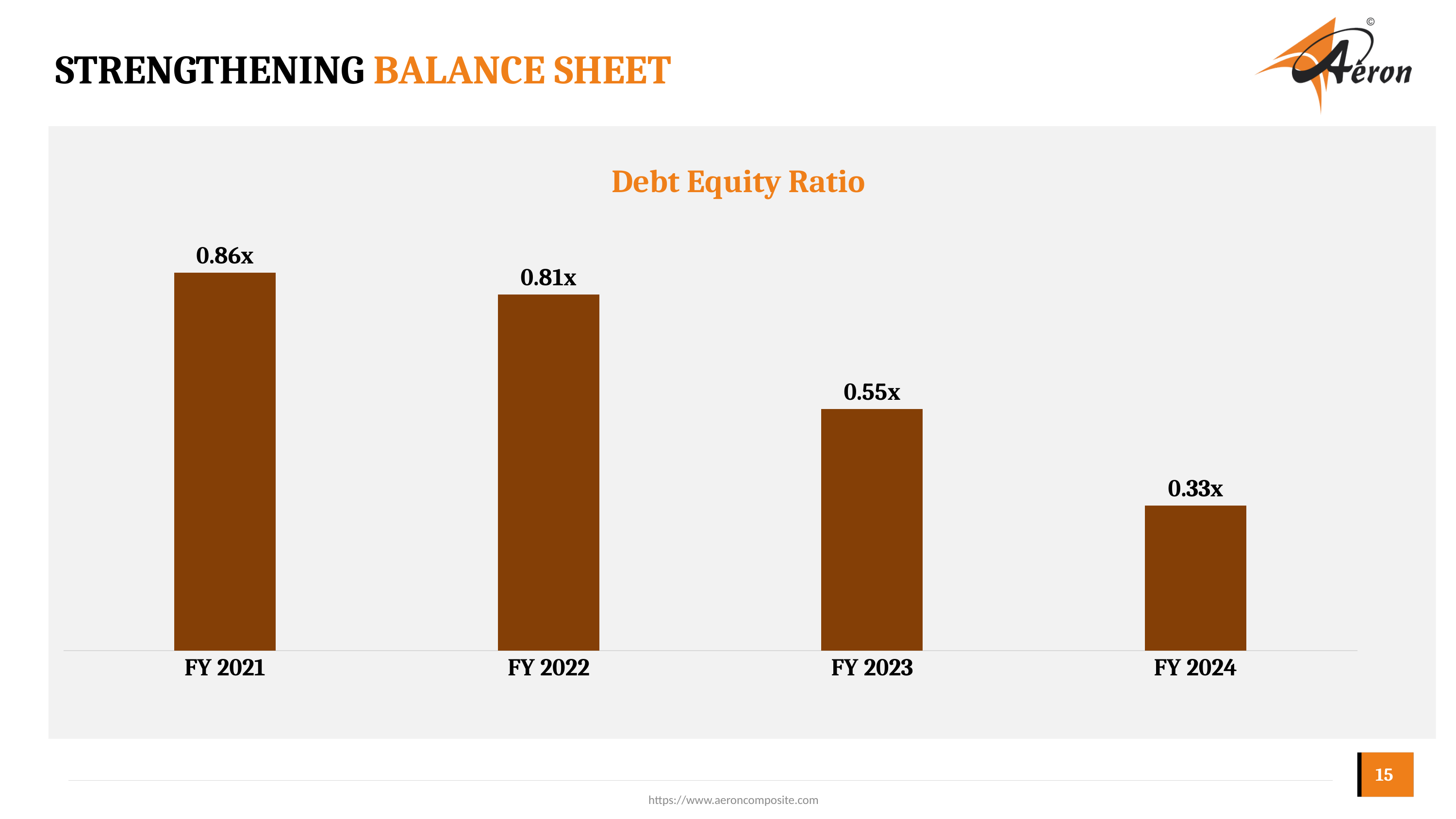
What is the difference between the Debt Equity Ratio in FY 2021 and FY 2024? 0.53x What kind of chart is used to show the Debt Equity Ratio? Bar chart Which fiscal year has the highest Debt Equity Ratio? FY 2021 Which is larger, the Debt Equity Ratio in FY 2022 or in FY 2023? FY 2022 What is the Debt Equity Ratio for FY 2022? 0.81x What is the Debt Equity Ratio for FY 2024? 0.33x Which fiscal year has the lowest Debt Equity Ratio? FY 2024 How many fiscal years are shown in the Debt Equity Ratio chart? 4 What is the Debt Equity Ratio for FY 2023? 0.55x What is the difference between the Debt Equity Ratio in FY 2022 and FY 2023? 0.26x What is the Debt Equity Ratio for FY 2021? 0.86x Does the Debt Equity Ratio rise or fall from FY 2021 to FY 2024? Fall